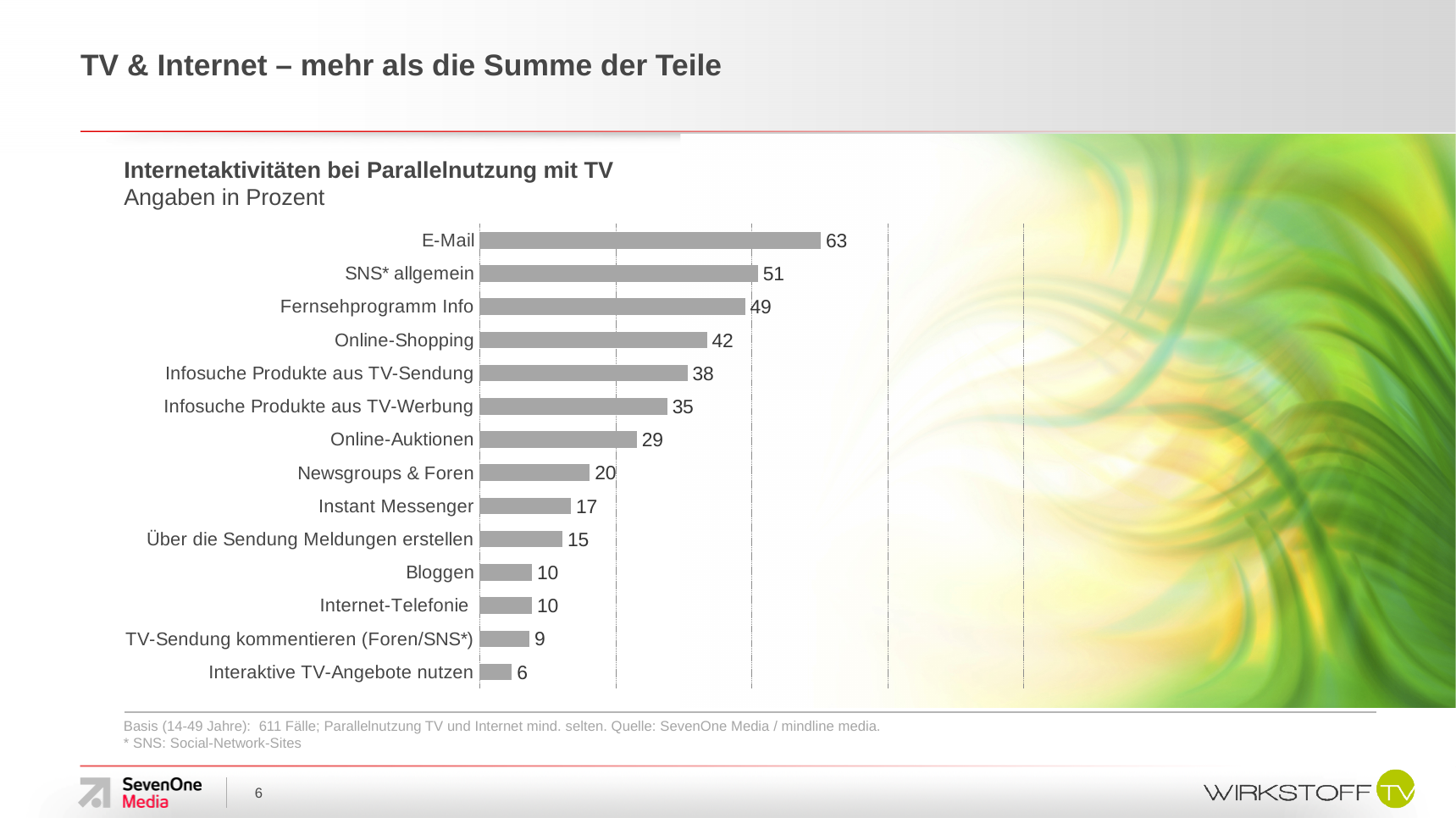
What is the difference between the values for Online-Auktionen and Instant Messenger? 12 What is the value for TV-Sendung kommentieren (Foren/SNS*)? 9 What is the value for E-Mail? 63 Which category has the lowest value? Interaktive TV-Angebote nutzen What is the value for Online-Shopping? 42 Which is larger, the value for Infosuche Produkte aus TV-Sendung or the value for Infosuche Produkte aus TV-Werbung? Infosuche Produkte aus TV-Sendung How many categories are shown in the chart? 14 What is the value for Newsgroups & Foren? 20 What is the difference between the values for E-Mail and SNS* allgemein? 12 What is the title of the chart? Internetaktivitäten bei Parallelnutzung mit TV What kind of chart is shown on the slide? bar chart Which category has the highest value? E-Mail